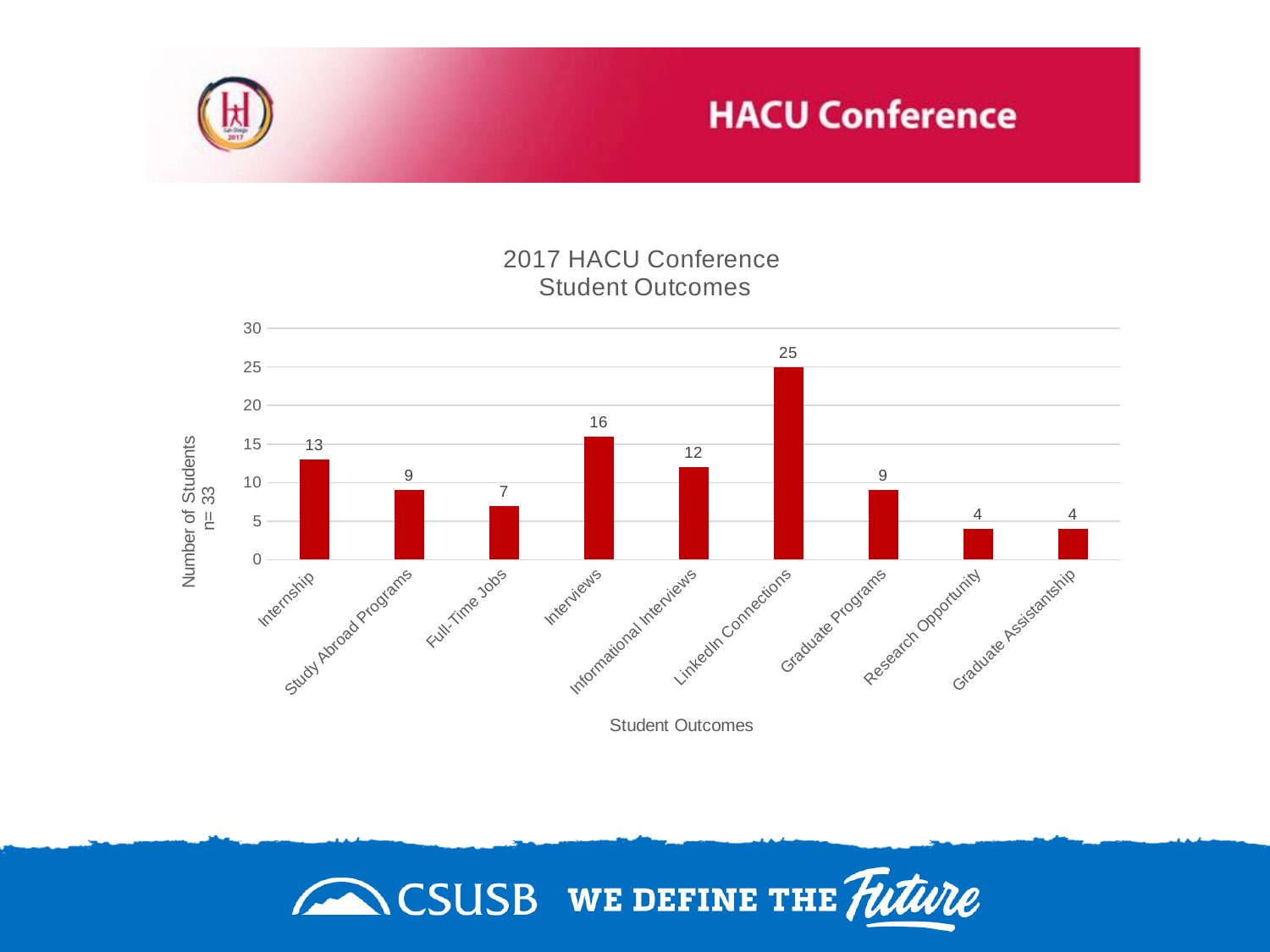
What is the difference between the values for LinkedIn Connections and Research Opportunity? 21 What kind of chart is shown on the slide? Bar chart What is the label of the y axis? Number of Students n= 33 Which is larger, the value for Internship or the value for Graduate Programs? Internship How many student outcome categories are shown on the chart? 9 What is the value for Full-Time Jobs? 7 What is the value for LinkedIn Connections? 25 What is the value for Internship? 13 What is the difference between the values for Interviews and Informational Interviews? 4 Which student outcome has the highest number of students? LinkedIn Connections Is the value for Interviews greater or less than 15? greater What is the title of the chart? 2017 HACU Conference Student Outcomes